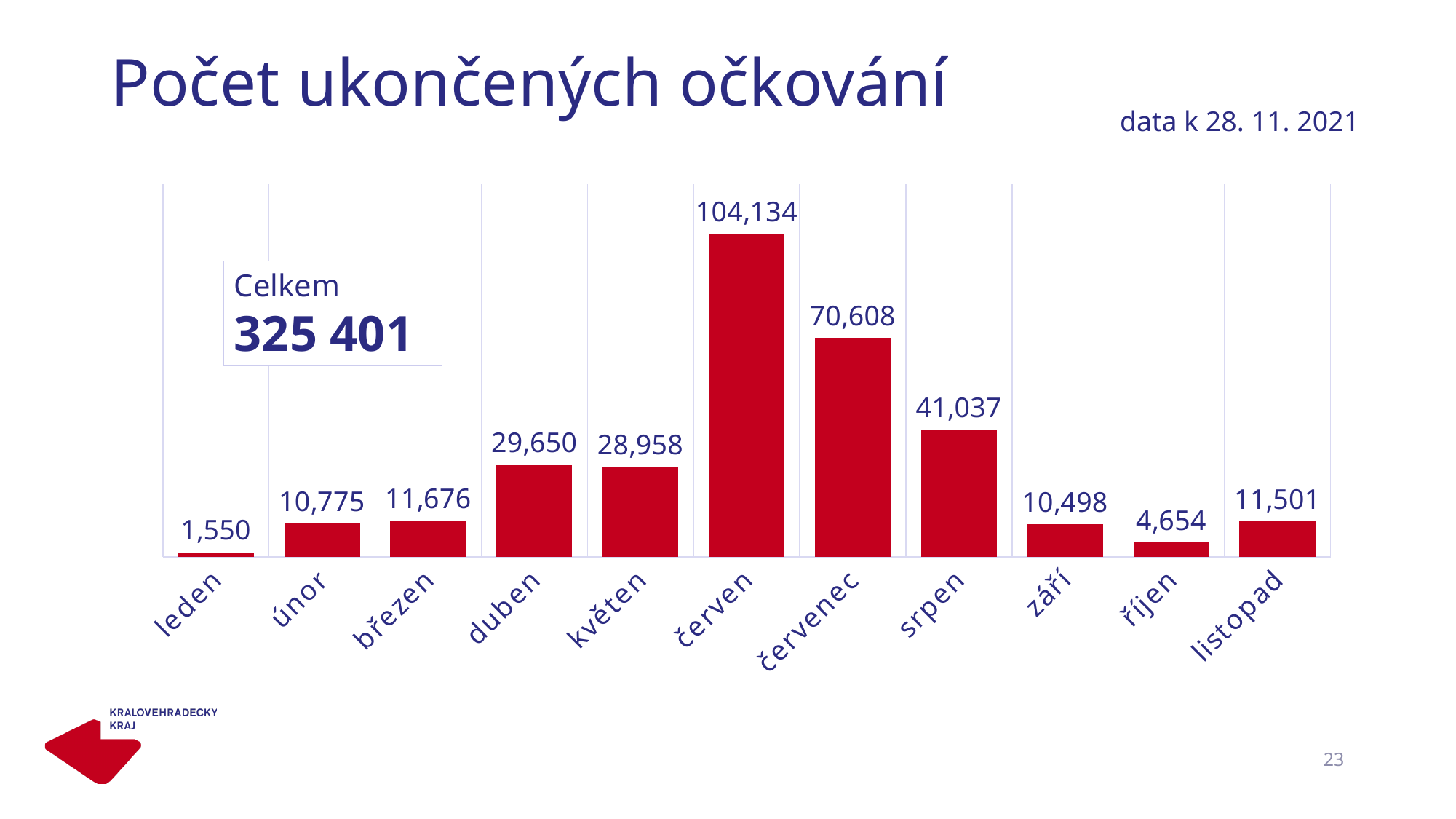
Which month has the lowest value? leden Do the values rise or fall from červen to říjen? fall How many months are shown on the x axis? 11 What is the value for leden? 1,550 What is the difference between the values for červen and červenec? 33,526 Which is larger, the value for srpen or the value for květen? srpen What total (Celkem) is shown in the box on the chart? 325 401 What is the value for listopad? 11,501 What is the value for červen? 104,134 Which month has the highest value? červen What is the difference between the values for listopad and říjen? 6,847 What kind of chart is shown on the slide? bar chart